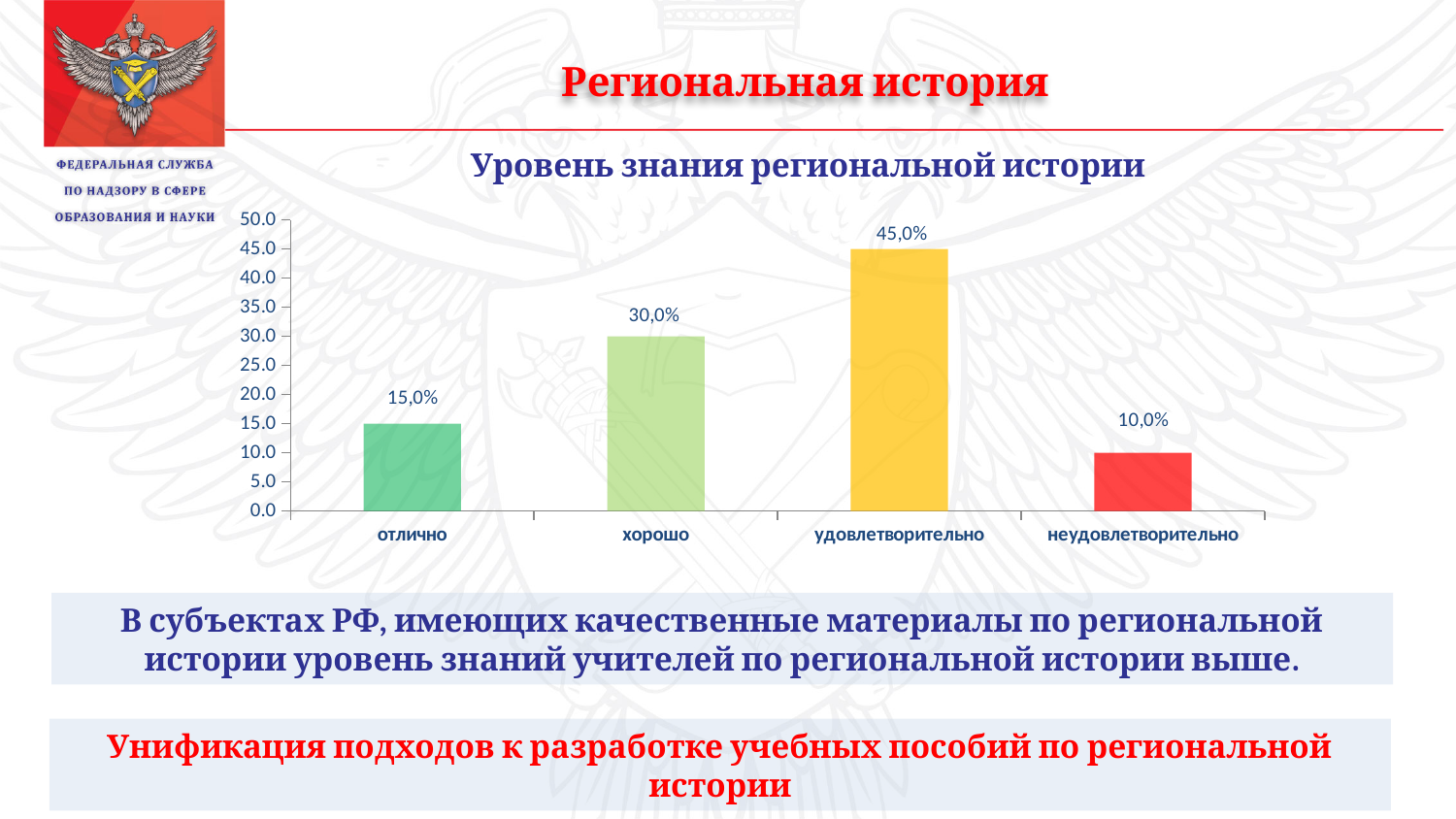
What is the value for отлично? 15,0% Which is larger, the value for отлично or the value for неудовлетворительно? отлично What is the difference between the values for удовлетворительно and хорошо? 15,0% Which category has the lowest value? неудовлетворительно How many categories are shown on the x axis? 4 What is the title of the chart? Уровень знания региональной истории What kind of chart is shown on the slide? bar chart What is the value for хорошо? 30,0% Is the value for хорошо greater or less than 25.0? greater What is the value for неудовлетворительно? 10,0% What is the value for удовлетворительно? 45,0% Which category has the highest value? удовлетворительно